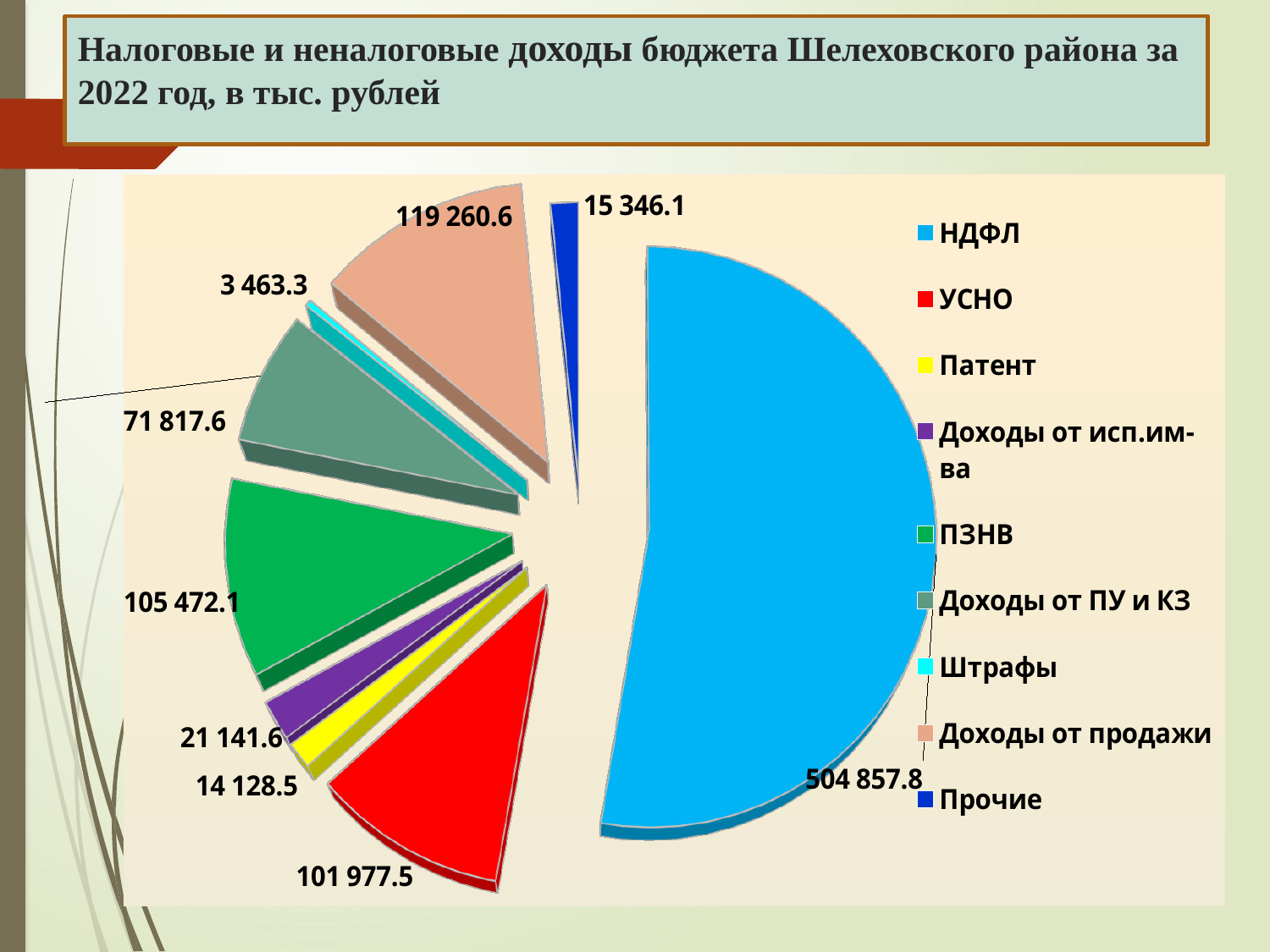
What is the difference between Доходы от продажи and ПЗНВ? 13 788.5 What is the value for НДФЛ? 504 857.8 What is the value for Прочие? 15 346.1 What colour is the slice for УСНО? Red Which category has the largest slice? НДФЛ How many categories does the legend list? 9 What is the value for Доходы от продажи? 119 260.6 What is the difference between Доходы от исп.им-ва and Патент? 7 013.1 What type of chart is shown on the slide? Pie chart Which category has the smallest slice? Штрафы Which is larger, УСНО or ПЗНВ? ПЗНВ What is the value for Штрафы? 3 463.3